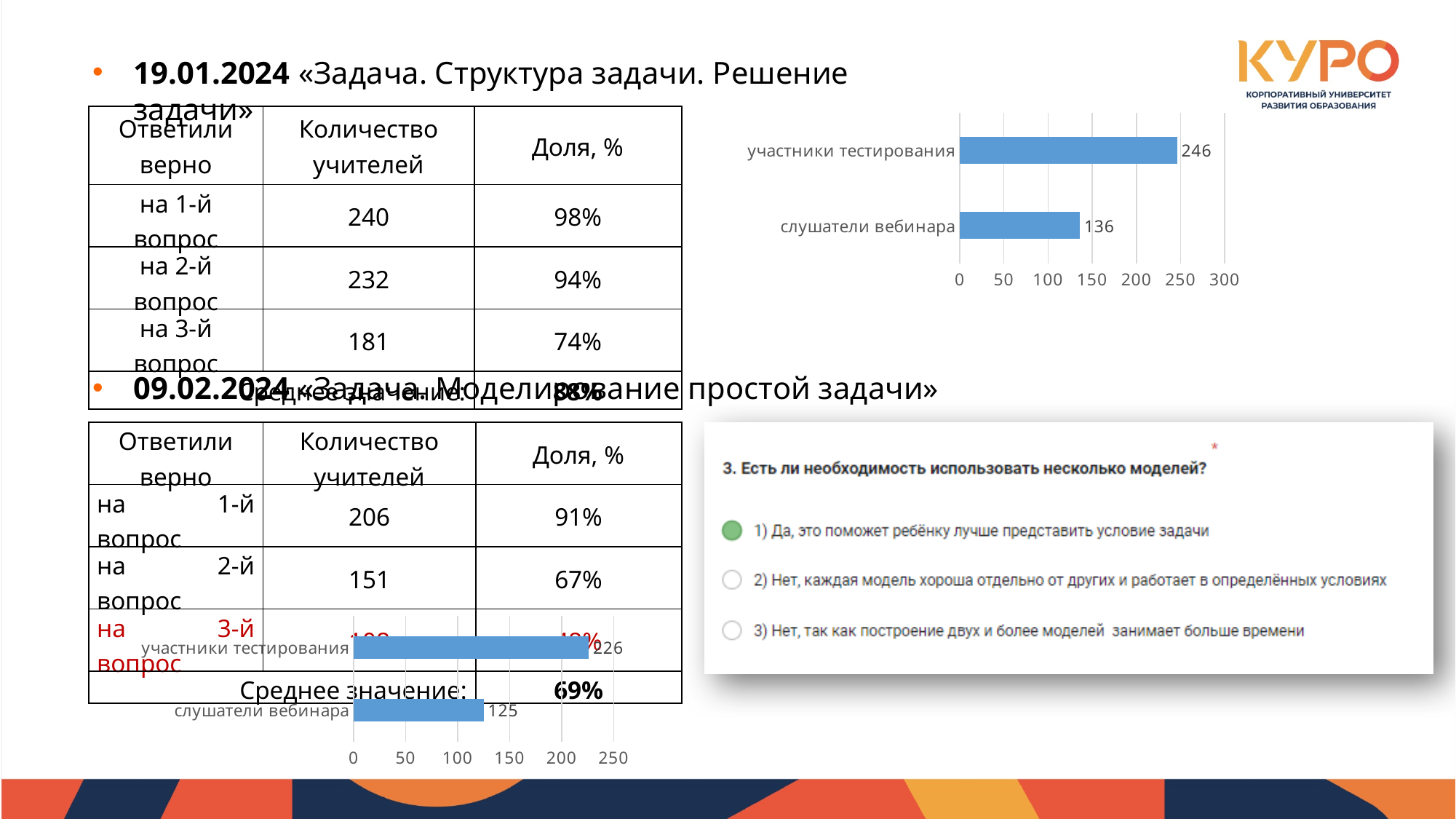
In the top-right bar chart, how many categories are shown? 2 In the top-right bar chart, which category has the highest value? участники тестирования In the top-right bar chart, what is the highest value shown on the horizontal axis? 300 In the top-right bar chart, what is the value for участники тестирования? 246 In the bottom-left bar chart, which category has the lowest value? слушатели вебинара What type of chart is the top-right chart? bar chart In the bottom-left bar chart, what is the value for участники тестирования? 226 In the bottom-left bar chart, is the value for слушатели вебинара greater or less than 150? less In the bottom-left bar chart, what is the difference between участники тестирования and слушатели вебинара? 101 In the bottom-left bar chart, what is the value for слушатели вебинара? 125 In the top-right bar chart, what is the difference between участники тестирования and слушатели вебинара? 110 In the top-right bar chart, what is the value for слушатели вебинара? 136